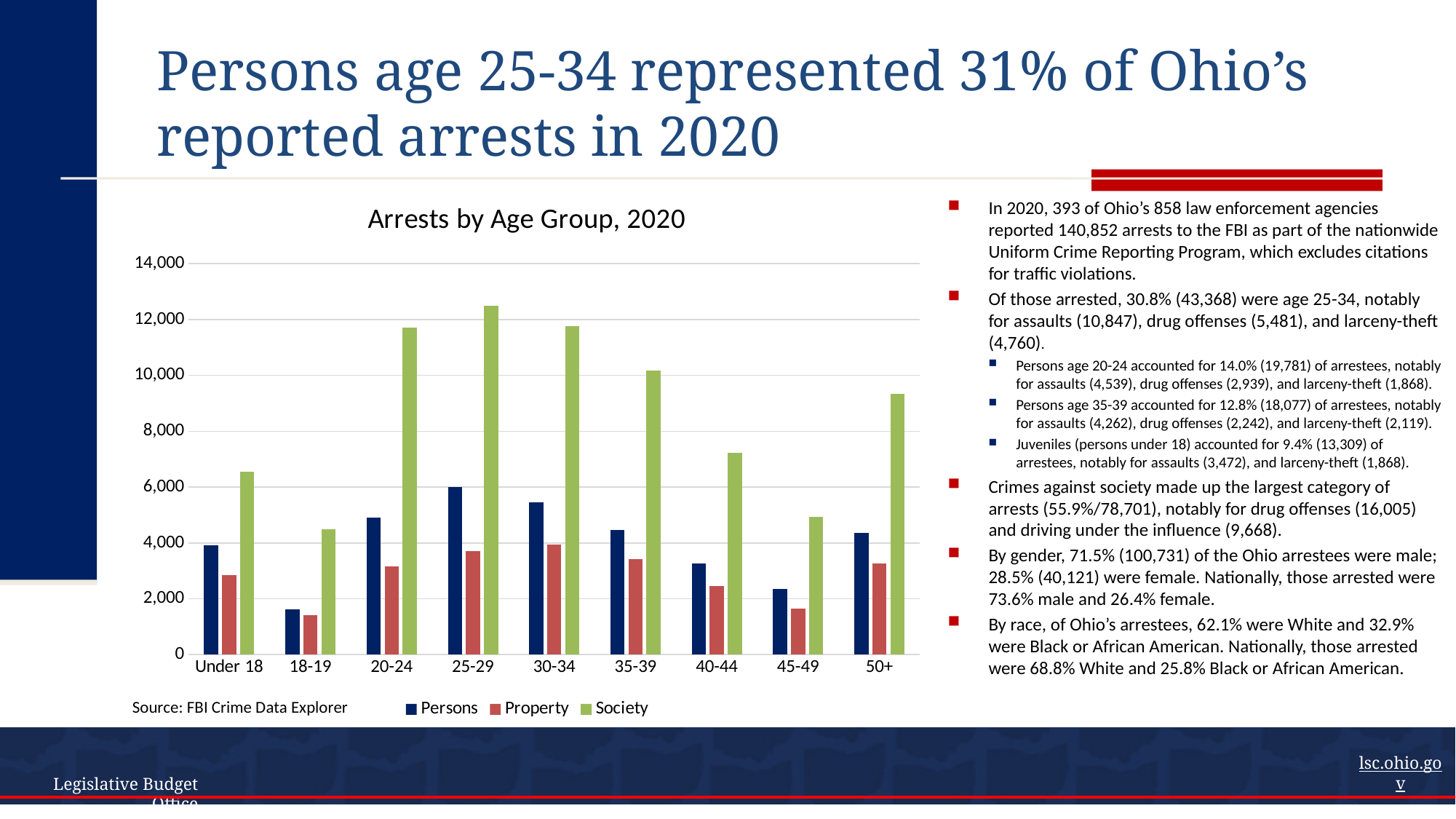
Which age group has the lowest Society value? 18-19 What source is cited below the chart? FBI Crime Data Explorer Is the Property value for 18-19 greater or less than 2,000? less Which age group has the highest Persons value? 25-29 Which age group has the lowest Persons value? 18-19 Is the Society value for 20-24 greater or less than 10,000? greater How many series does the chart's legend list? 3 Which age group has the larger Society value, 30-34 or 35-39? 30-34 How many age groups are shown on the x axis of the chart? 9 Which age group has the highest Society value? 25-29 What kind of chart is shown on the slide? bar chart What is the title of the chart? Arrests by Age Group, 2020